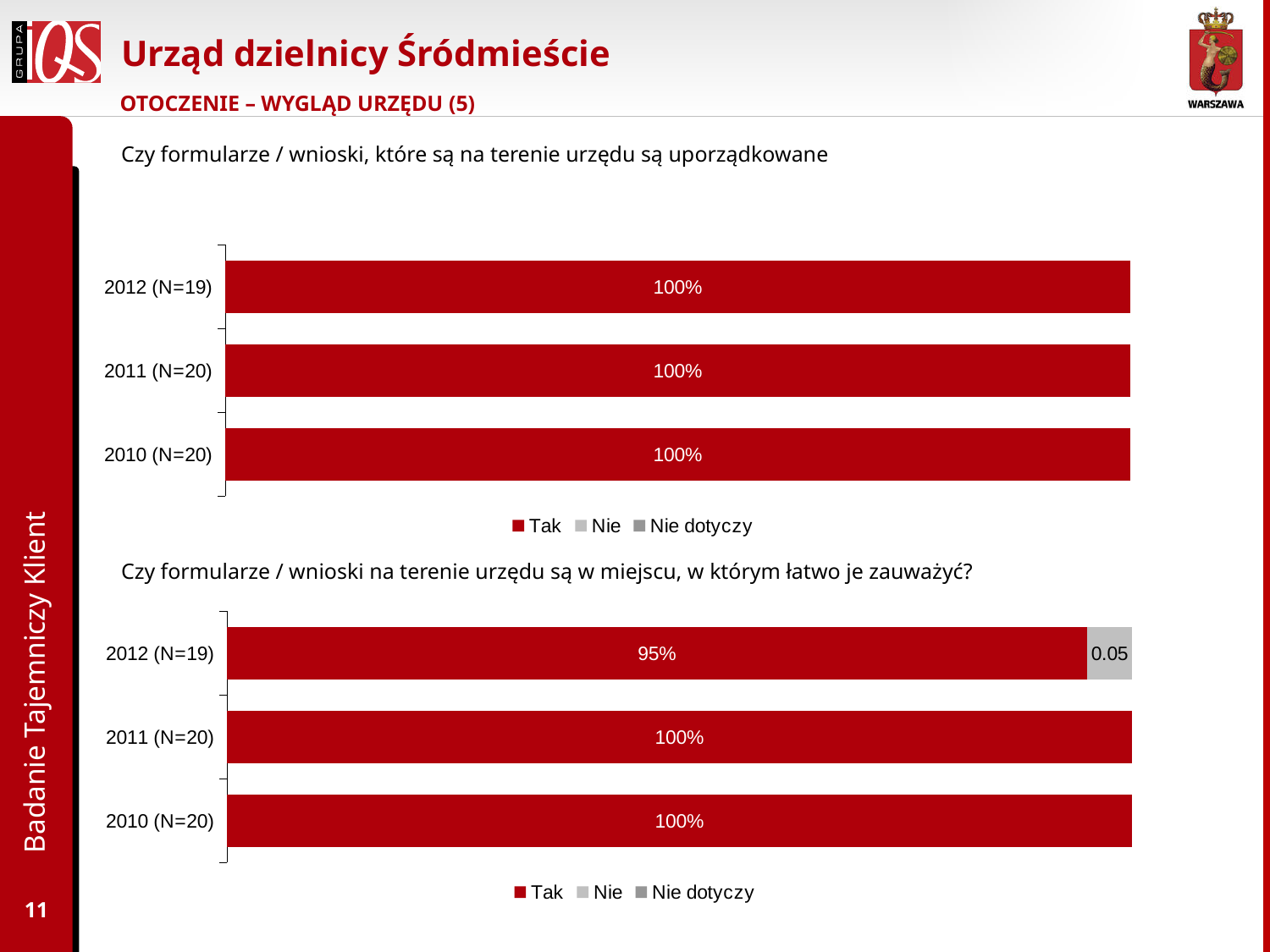
In the bottom chart ("Czy formularze / wnioski na terenie urzędu są w miejscu, w którym łatwo je zauważyć?"), what is the value of "Tak" for 2011 (N=20)? 100% How many categories (years) are shown in the top chart ("Czy formularze / wnioski, które są na terenie urzędu są uporządkowane")? 3 How many series does the legend of the bottom chart ("Czy formularze / wnioski na terenie urzędu są w miejscu, w którym łatwo je zauważyć?") list? 3 In the bottom chart ("Czy formularze / wnioski na terenie urzędu są w miejscu, w którym łatwo je zauważyć?"), what is the value of "Tak" for 2012 (N=19)? 95% What type of chart is the top chart ("Czy formularze / wnioski, które są na terenie urzędu są uporządkowane")? bar chart In the bottom chart ("Czy formularze / wnioski na terenie urzędu są w miejscu, w którym łatwo je zauważyć?"), which year has the lowest "Tak" value? 2012 (N=19) In the bottom chart ("Czy formularze / wnioski na terenie urzędu są w miejscu, w którym łatwo je zauważyć?"), what is the value of "Nie" for 2012 (N=19)? 0.05 In the top chart ("Czy formularze / wnioski, które są na terenie urzędu są uporządkowane"), what is the value of "Tak" for 2010 (N=20)? 100% What are the legend entries of the top chart ("Czy formularze / wnioski, które są na terenie urzędu są uporządkowane")? Tak, Nie, Nie dotyczy In the top chart ("Czy formularze / wnioski, które są na terenie urzędu są uporządkowane"), what is the value of "Tak" for 2012 (N=19)? 100% In the bottom chart ("Czy formularze / wnioski na terenie urzędu są w miejscu, w którym łatwo je zauważyć?"), what is the difference between the "Tak" value for 2011 (N=20) and for 2012 (N=19)? 5% In the bottom chart ("Czy formularze / wnioski na terenie urzędu są w miejscu, w którym łatwo je zauważyć?"), is the "Tak" value for 2010 (N=20) larger or smaller than for 2012 (N=19)? larger